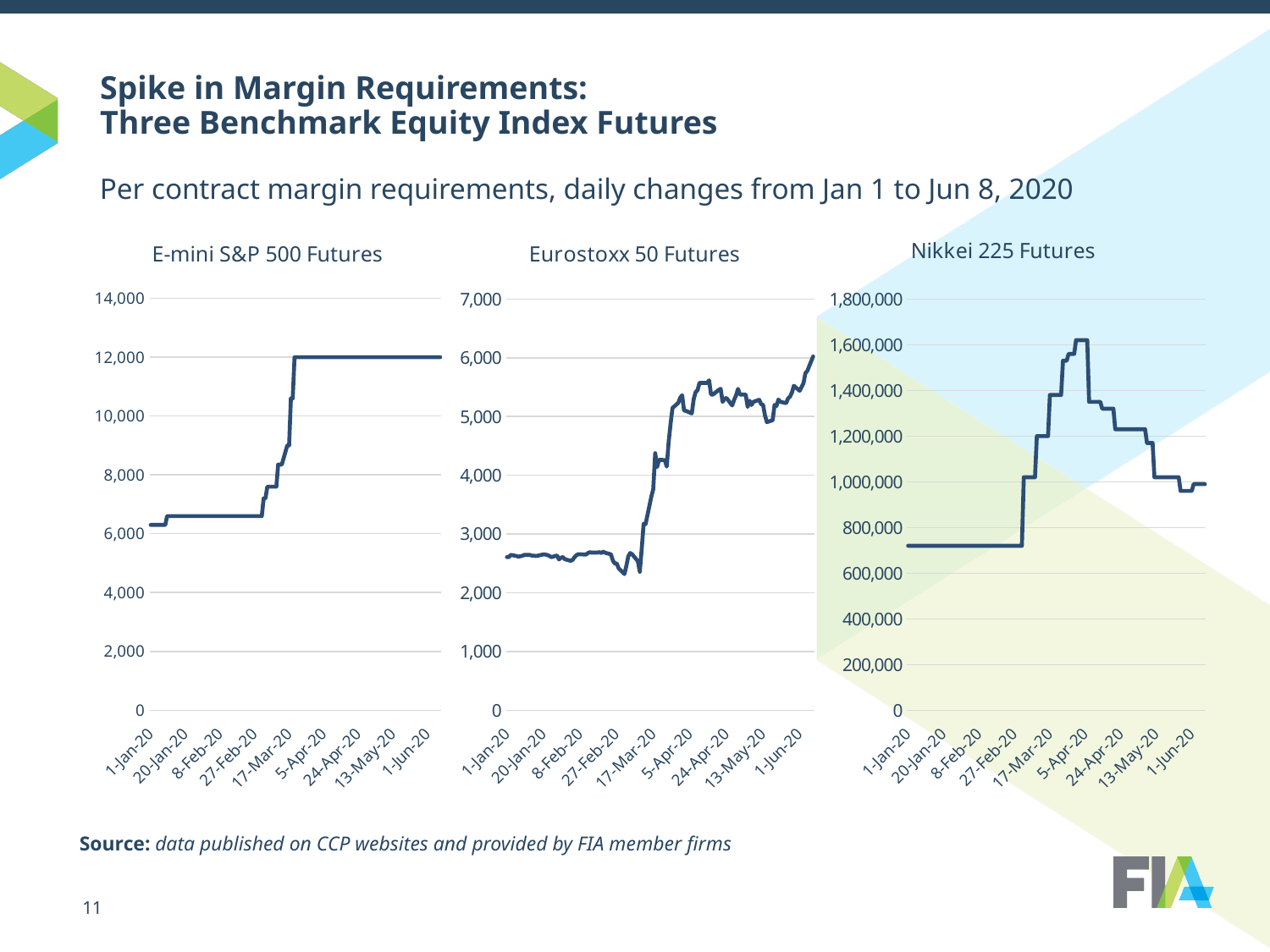
In the Eurostoxx 50 Futures chart, do the values overall rise or fall from January to June 2020? Rise In the Eurostoxx 50 Futures chart, is the value at 1-Jun-20 greater or less than 5,000? greater In the E-mini S&P 500 Futures chart, what value does the line plateau at from April onward? 12,000 What kind of chart is the E-mini S&P 500 Futures chart? Line chart In the E-mini S&P 500 Futures chart, is the value at 1-Jan-20 greater or less than 8,000? less In the Nikkei 225 Futures chart, is the peak value greater or less than 1,400,000? greater In the Nikkei 225 Futures chart, do the values rise or fall between mid-April and June 2020? Fall How many charts are shown on the slide? 3 What is the title of the rightmost chart on the slide? Nikkei 225 Futures